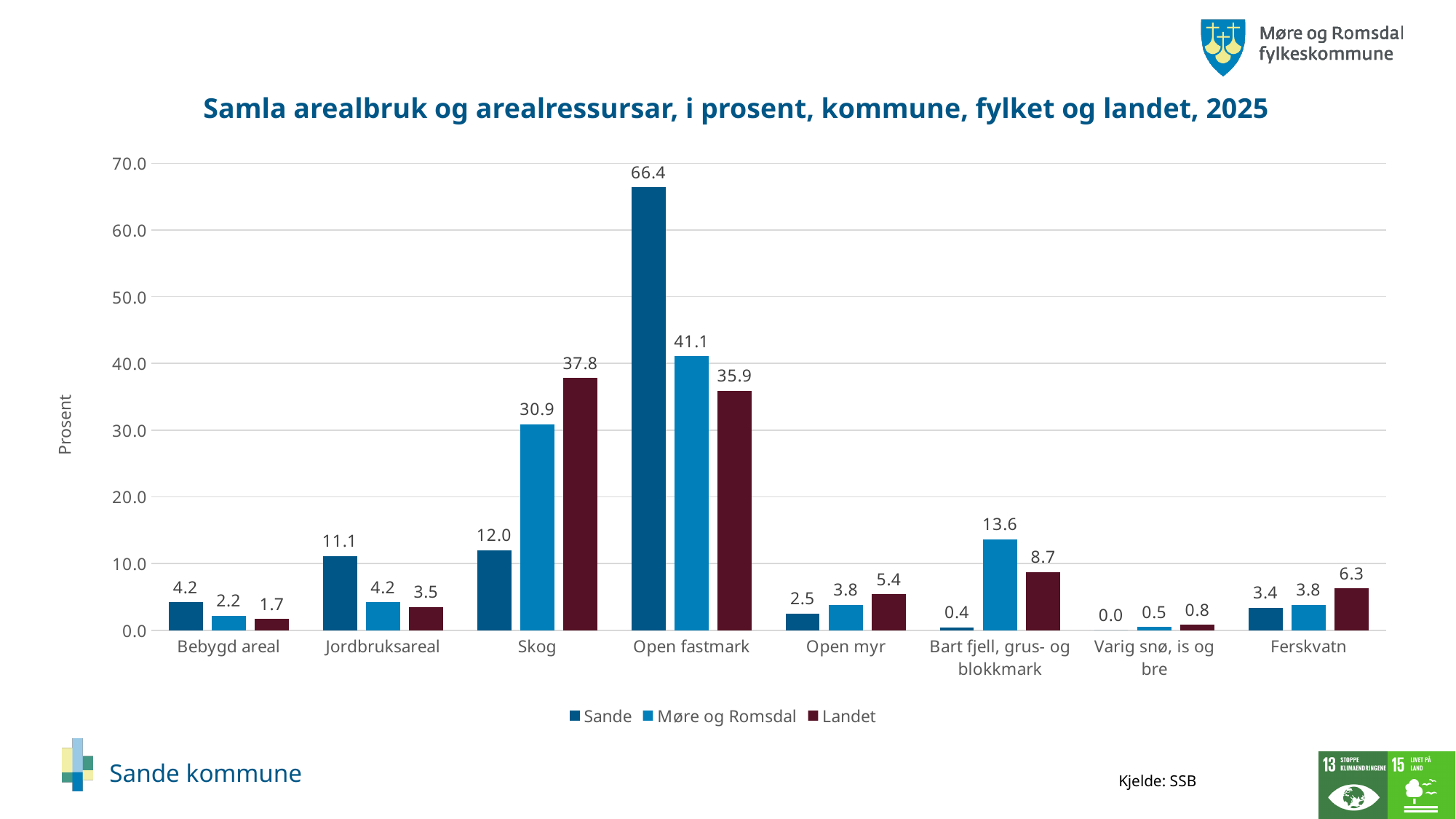
What kind of chart is shown on the slide? bar chart Which category has the lowest value for Landet? Varig snø, is og bre Which is larger for Skog: the value for Sande or the value for Møre og Romsdal? Møre og Romsdal Which category has the highest value for Sande? Open fastmark What is the value for Landet in the Skog category? 37.8 What is the value for Sande in the Open fastmark category? 66.4 How many categories are shown on the x axis? 8 Is the value for Sande in the Open fastmark category greater or less than 60.0? greater What is the label of the y axis? Prosent What is the difference between the Sande and Landet values for Open fastmark? 30.5 What is the value for Møre og Romsdal in the Bart fjell, grus- og blokkmark category? 13.6 How many series does the legend list? 3